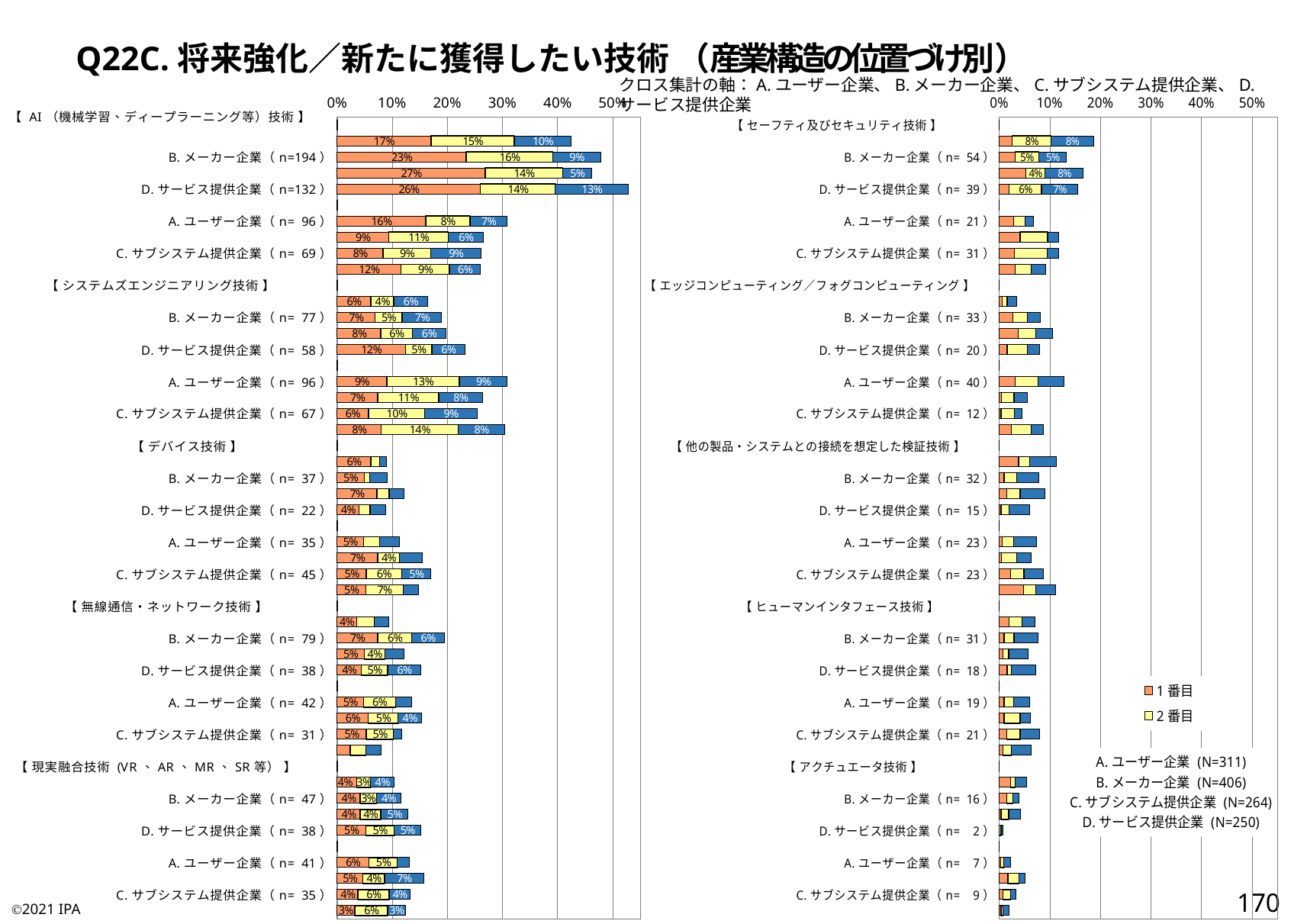
Which colour represents 1番目 in the legend? orange In the left chart, what is the 1番目 value for D. サービス提供企業 (n=58) in the システムズエンジニアリング技術 section? 12% What is the highest value shown on the horizontal axis of the charts? 50% In the left chart, is the total bar length for D. サービス提供企業 (n=132) in the AI section greater or less than 50%? greater What kind of chart is used on the left side of the slide? bar chart In the left chart, what is the total of the stacked bar for B. メーカー企業 (n=194) in the AI section? 48% In the left chart, what is the 1番目 value for D. サービス提供企業 (n=132) in the AI section? 26% In the left chart, what is the 2番目 value for B. メーカー企業 (n=194) in the AI section? 16% In the left chart, what is the total of the stacked bar for D. サービス提供企業 (n=132) in the AI section? 53% In the left chart, what is the difference between the 1番目 values of D. サービス提供企業 (n=132) and B. メーカー企業 (n=194) in the AI section? 3% In the left chart, which has the larger 1番目 value in the AI section: B. メーカー企業 (n=194) or D. サービス提供企業 (n=132)? D. サービス提供企業 (n=132)